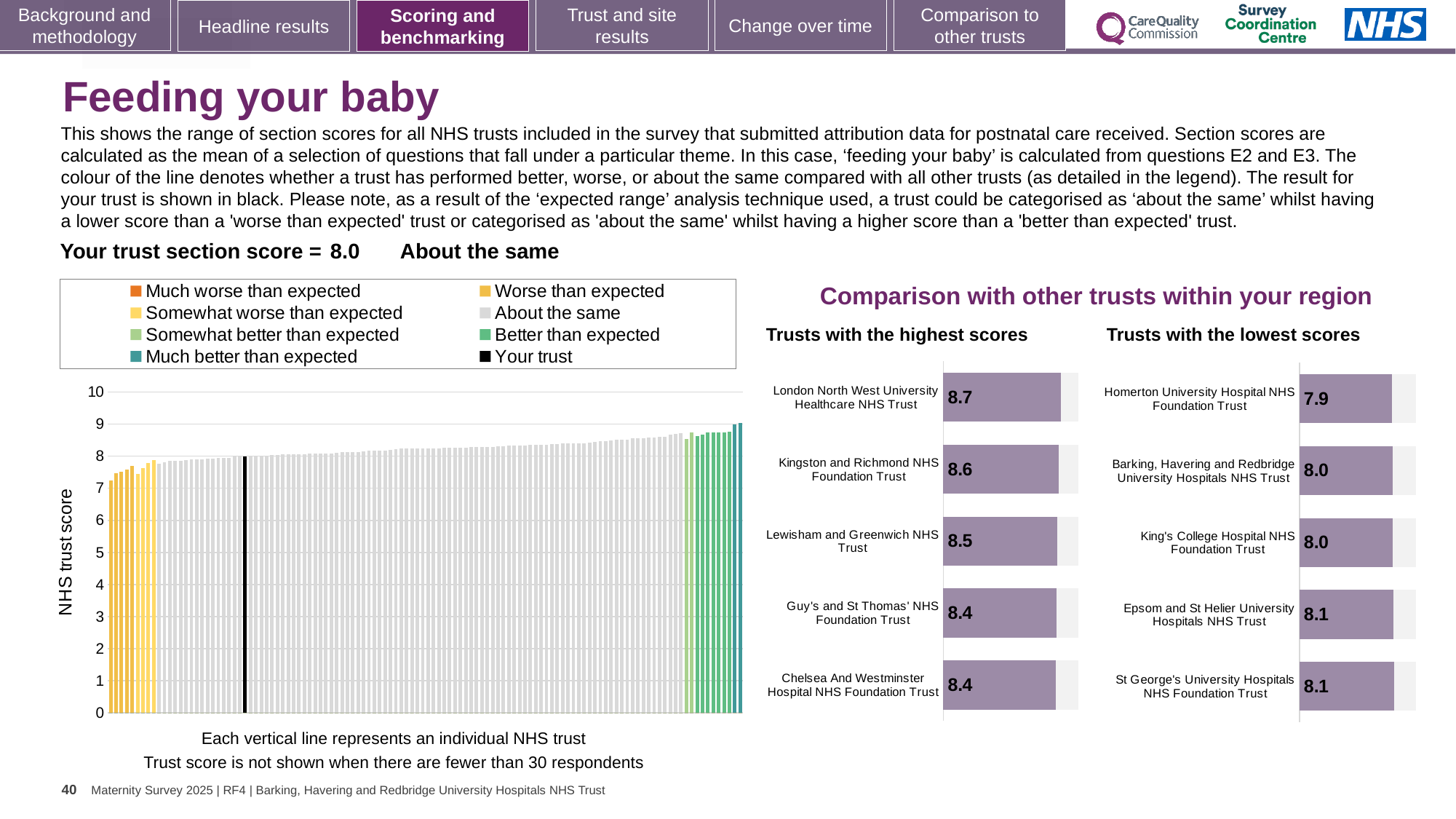
In the 'Trusts with the highest scores' chart, what is the score for Lewisham and Greenwich NHS Trust? 8.5 In the 'Trusts with the highest scores' chart, what is the difference between the scores of London North West University Healthcare NHS Trust and Chelsea And Westminster Hospital NHS Foundation Trust? 0.3 In the 'Trusts with the highest scores' chart, what is the score for London North West University Healthcare NHS Trust? 8.7 In the 'Trusts with the lowest scores' chart, which trust has the lowest score? Homerton University Hospital NHS Foundation Trust In the 'Trusts with the lowest scores' chart, which has the larger score: Homerton University Hospital NHS Foundation Trust or St George's University Hospitals NHS Foundation Trust? St George's University Hospitals NHS Foundation Trust In the 'Trusts with the lowest scores' chart, what is the score for Homerton University Hospital NHS Foundation Trust? 7.9 In the main 'NHS trust score' chart, do the bar values rise or fall from left to right? rise In the 'Trusts with the lowest scores' chart, what is the score for Epsom and St Helier University Hospitals NHS Trust? 8.1 In the 'Trusts with the highest scores' chart, which trust has the highest score? London North West University Healthcare NHS Trust In the main 'NHS trust score' chart, is the value of the highest bar greater or less than 8? greater How many entries does the legend of the main 'NHS trust score' chart list? 8 How many trusts are shown in the 'Trusts with the highest scores' chart? 5